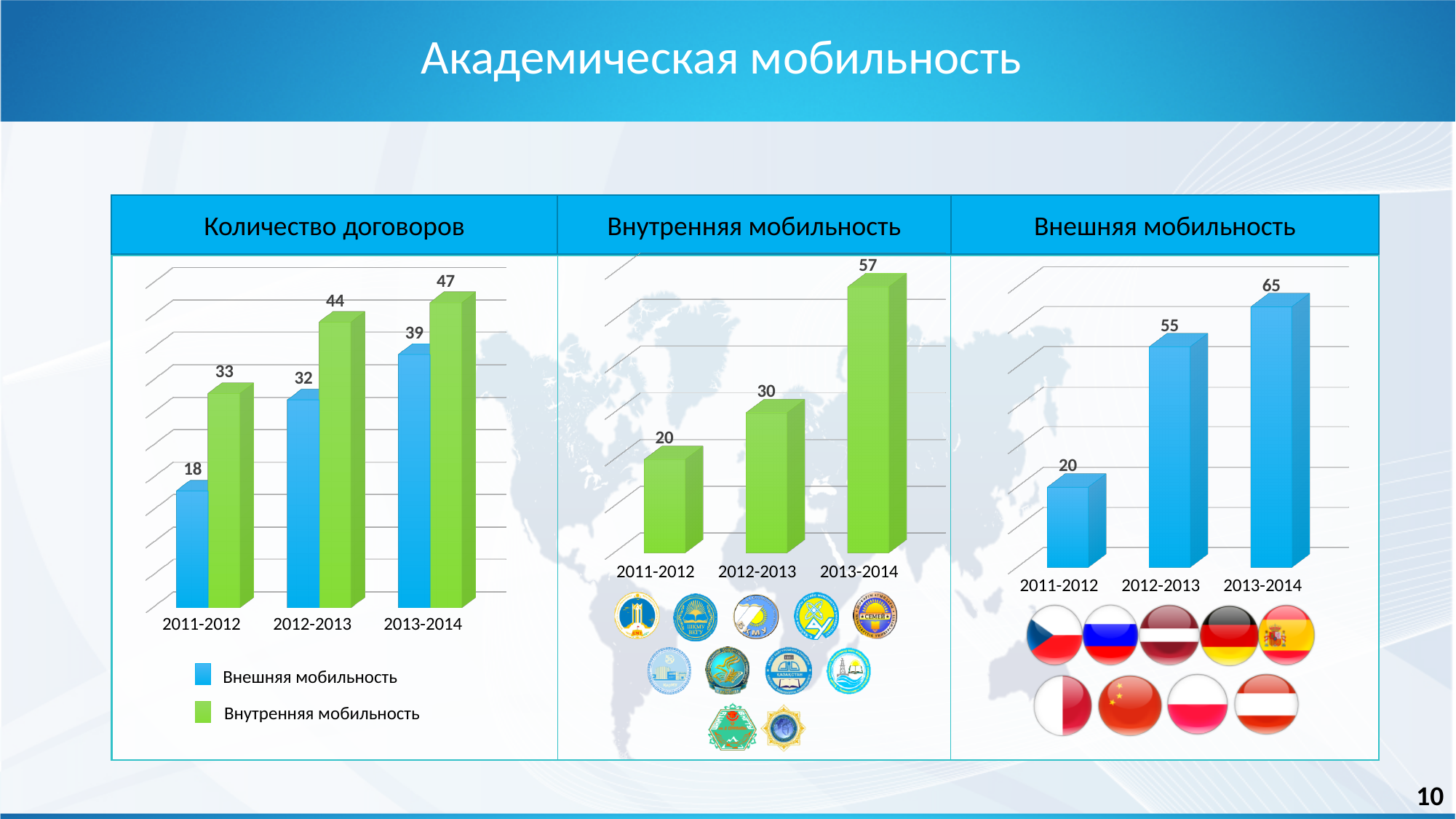
In the 'Внешняя мобильность' chart, what is the difference between 2012-2013 and 2011-2012? 35 In the 'Внешняя мобильность' chart, what is the value for 2013-2014? 65 In the 'Внешняя мобильность' chart, which year has the lowest value? 2011-2012 In the 'Количество договоров' chart, what is the value of Внешняя мобильность for 2011-2012? 18 In the 'Внутренняя мобильность' chart, what is the value for 2012-2013? 30 What kind of chart is the 'Внешняя мобильность' chart? bar chart In the 'Количество договоров' chart, what is the value of Внутренняя мобильность for 2013-2014? 47 In the 'Количество договоров' chart, how many series does the legend list? 2 In the 'Внутренняя мобильность' chart, which year has the highest value? 2013-2014 In the 'Внутренняя мобильность' chart, do the values rise or fall from 2011-2012 to 2013-2014? rise In the 'Количество договоров' chart, what is the difference between Внутренняя мобильность and Внешняя мобильность in 2012-2013? 12 In the 'Количество договоров' chart, which series is shown in green? Внутренняя мобильность